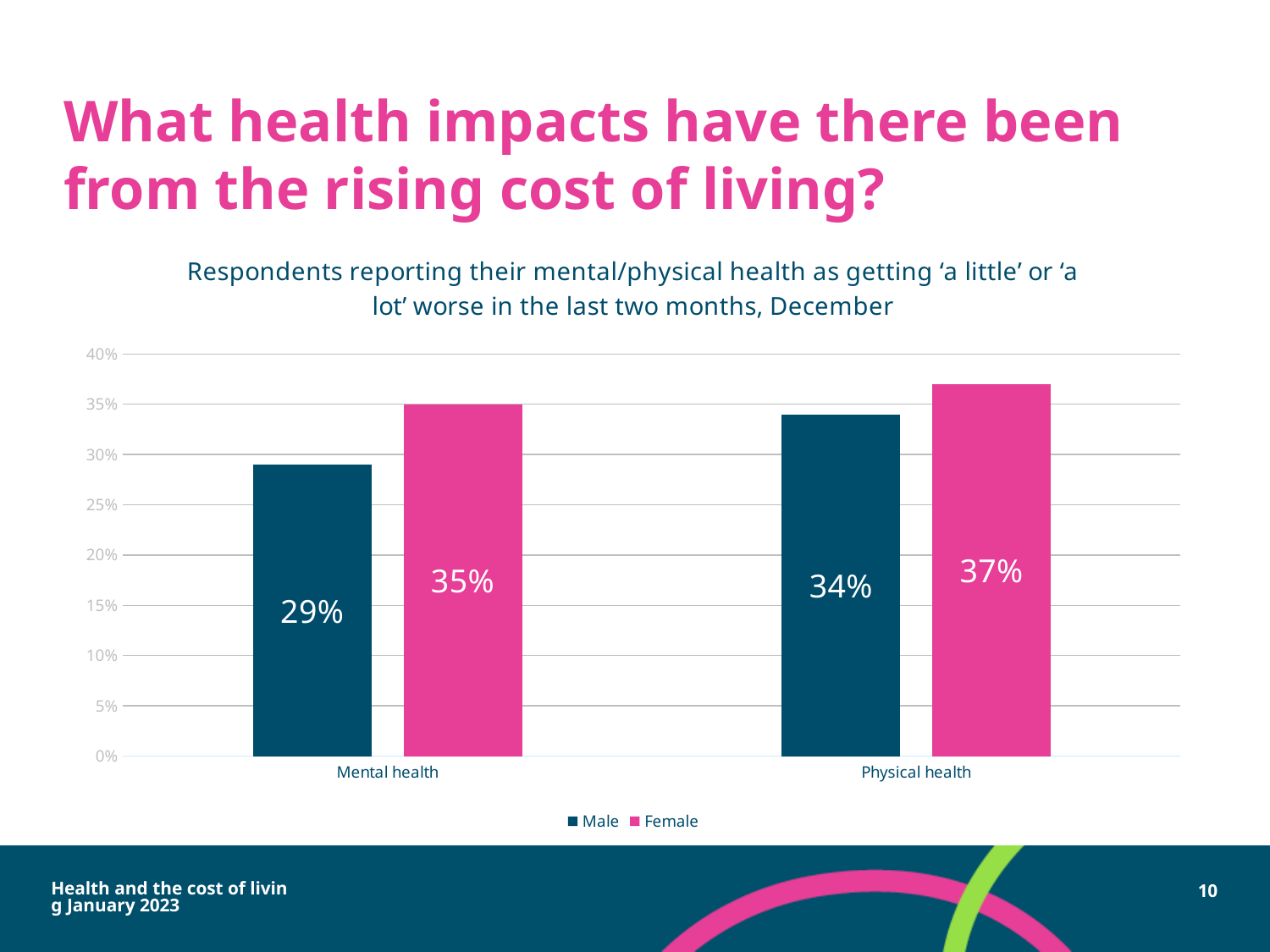
How many series does the legend list? 2 What percentage of female respondents reported their physical health getting worse? 37% Which bar has the lowest value on the chart? Male, Mental health Which is larger: the Male value for Physical health or the Female value for Mental health? Female value for Mental health What is the value for Female in the Mental health category? 35% What kind of chart is shown on the slide? Bar chart Which bar has the highest value on the chart? Female, Physical health What percentage of male respondents reported their mental health getting worse? 29% What is the value for Male in the Physical health category? 34% What is the difference between the Female and Male values for Mental health? 6% How many categories are shown on the x axis? 2 What is the difference between the Female and Male values for Physical health? 3%